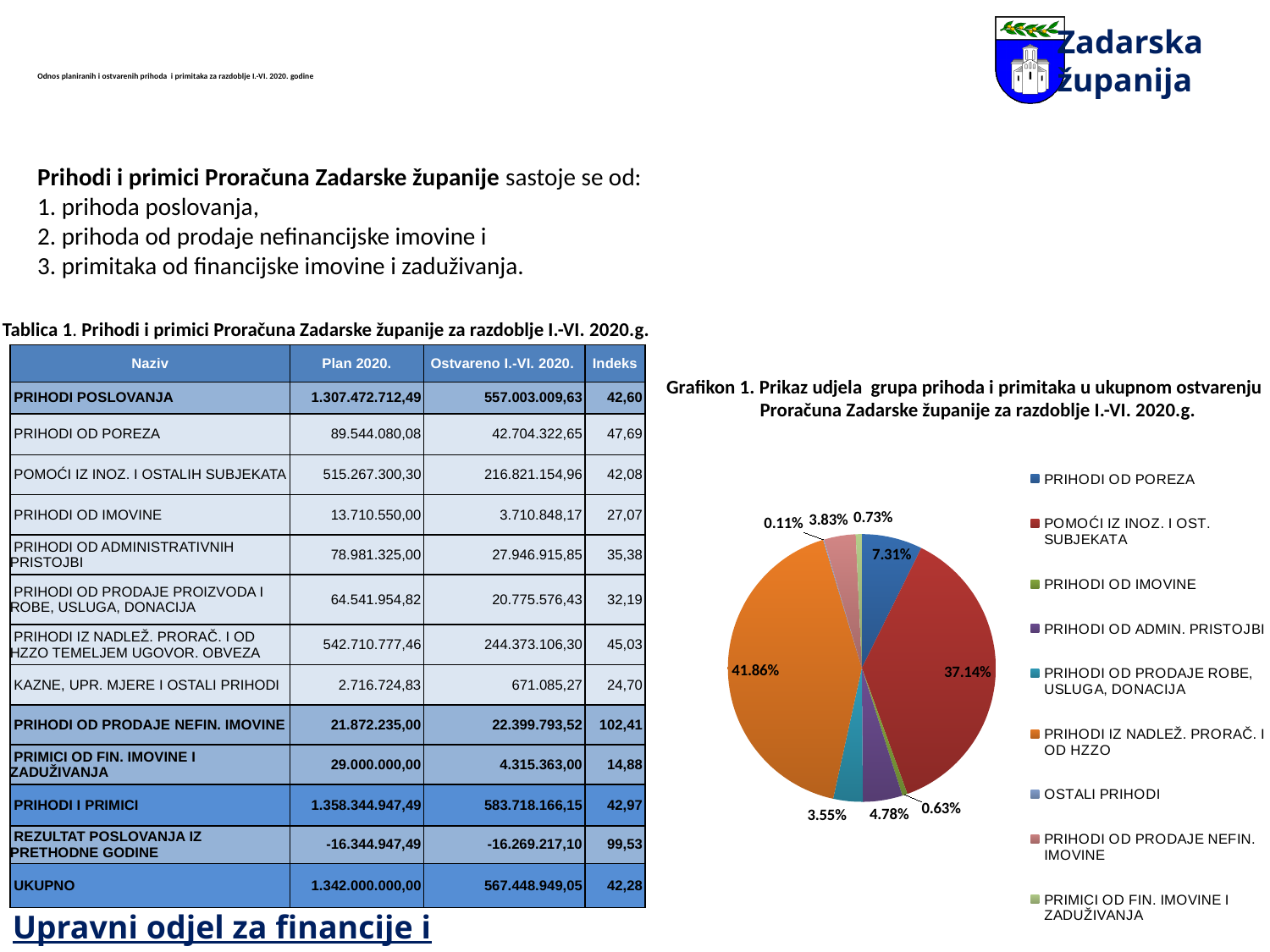
In the pie chart (Grafikon 1), what share is shown for PRIHODI OD PRODAJE NEFIN. IMOVINE? 3.83% In the pie chart (Grafikon 1), which has the larger share: PRIHODI OD PRODAJE ROBE, USLUGA, DONACIJA or PRIHODI OD ADMIN. PRISTOJBI? PRIHODI OD ADMIN. PRISTOJBI In the pie chart (Grafikon 1), what share is shown for POMOĆI IZ INOZ. I OST. SUBJEKATA? 37.14% In the pie chart (Grafikon 1), what is the difference in percentage points between the shares of PRIHODI IZ NADLEŽ. PRORAČ. I OD HZZO and POMOĆI IZ INOZ. I OST. SUBJEKATA? 4.72 percentage points In the pie chart (Grafikon 1), what colour is the slice for PRIHODI IZ NADLEŽ. PRORAČ. I OD HZZO? orange In the pie chart (Grafikon 1), which category has the largest share? PRIHODI IZ NADLEŽ. PRORAČ. I OD HZZO What kind of chart is Grafikon 1 on the slide? pie chart In the pie chart (Grafikon 1), what share is shown for PRIHODI OD ADMIN. PRISTOJBI? 4.78% How many categories does the legend of the pie chart (Grafikon 1) list? 9 In the pie chart (Grafikon 1), what share is shown for PRIHODI OD POREZA? 7.31% In the pie chart (Grafikon 1), what share is shown for PRIHODI IZ NADLEŽ. PRORAČ. I OD HZZO? 41.86% In the pie chart (Grafikon 1), which category has the smallest share? OSTALI PRIHODI